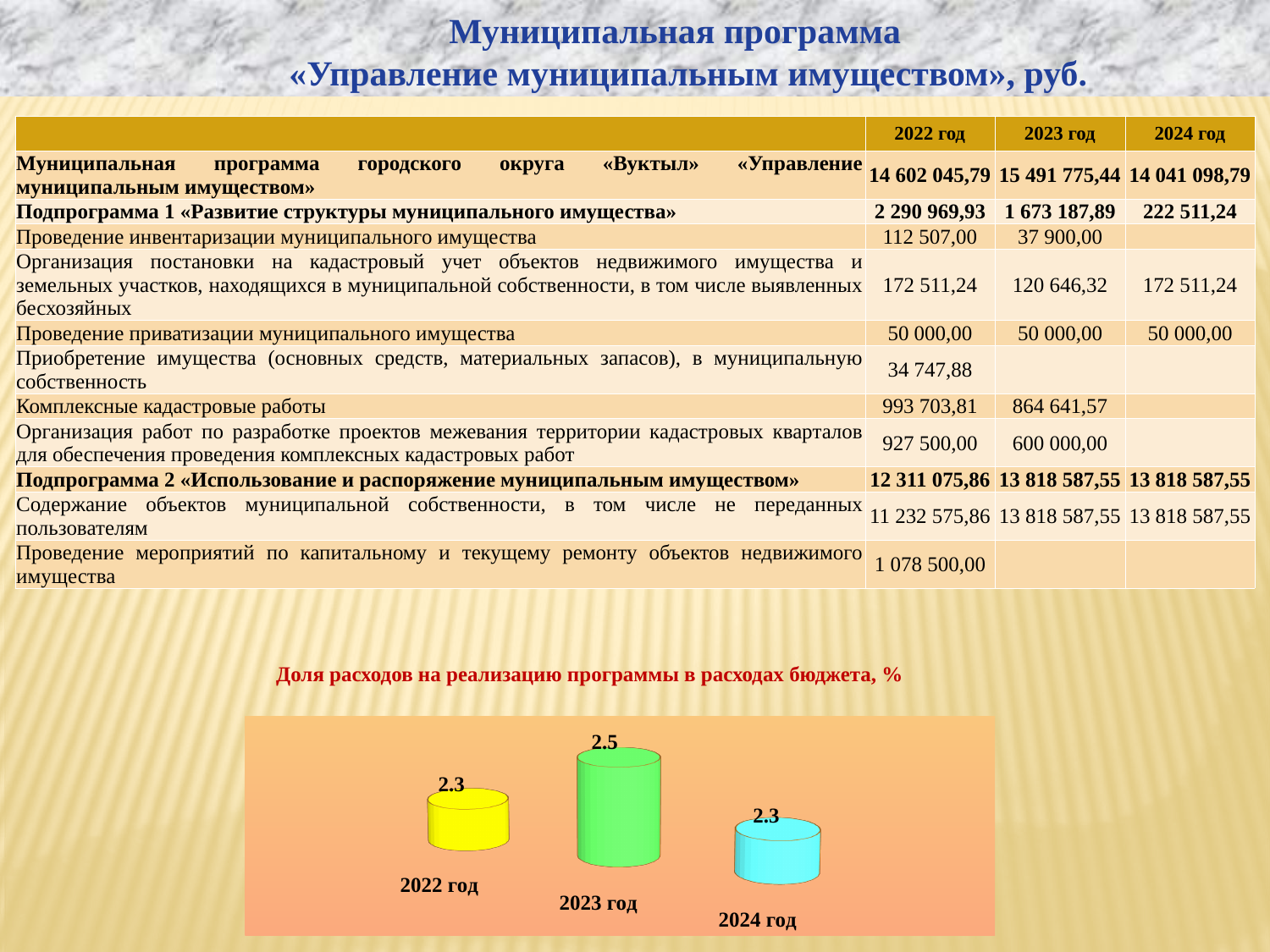
What colour is the bar for 2023 год in the chart? green What is the value shown for 2024 год in the chart? 2.3 What is the title of the chart? Доля расходов на реализацию программы в расходах бюджета, % Which year has the highest value in the chart? 2023 год What kind of chart is shown on the slide? bar chart What is the difference between the values for 2023 год and 2022 год in the chart? 0.2 Does the value rise or fall from 2023 год to 2024 год in the chart? fall How many years are plotted in the chart? 3 What is the value shown for 2023 год in the chart? 2.5 What is the value shown for 2022 год in the chart? 2.3 Which is larger in the chart, the value for 2023 год or the value for 2024 год? 2023 год